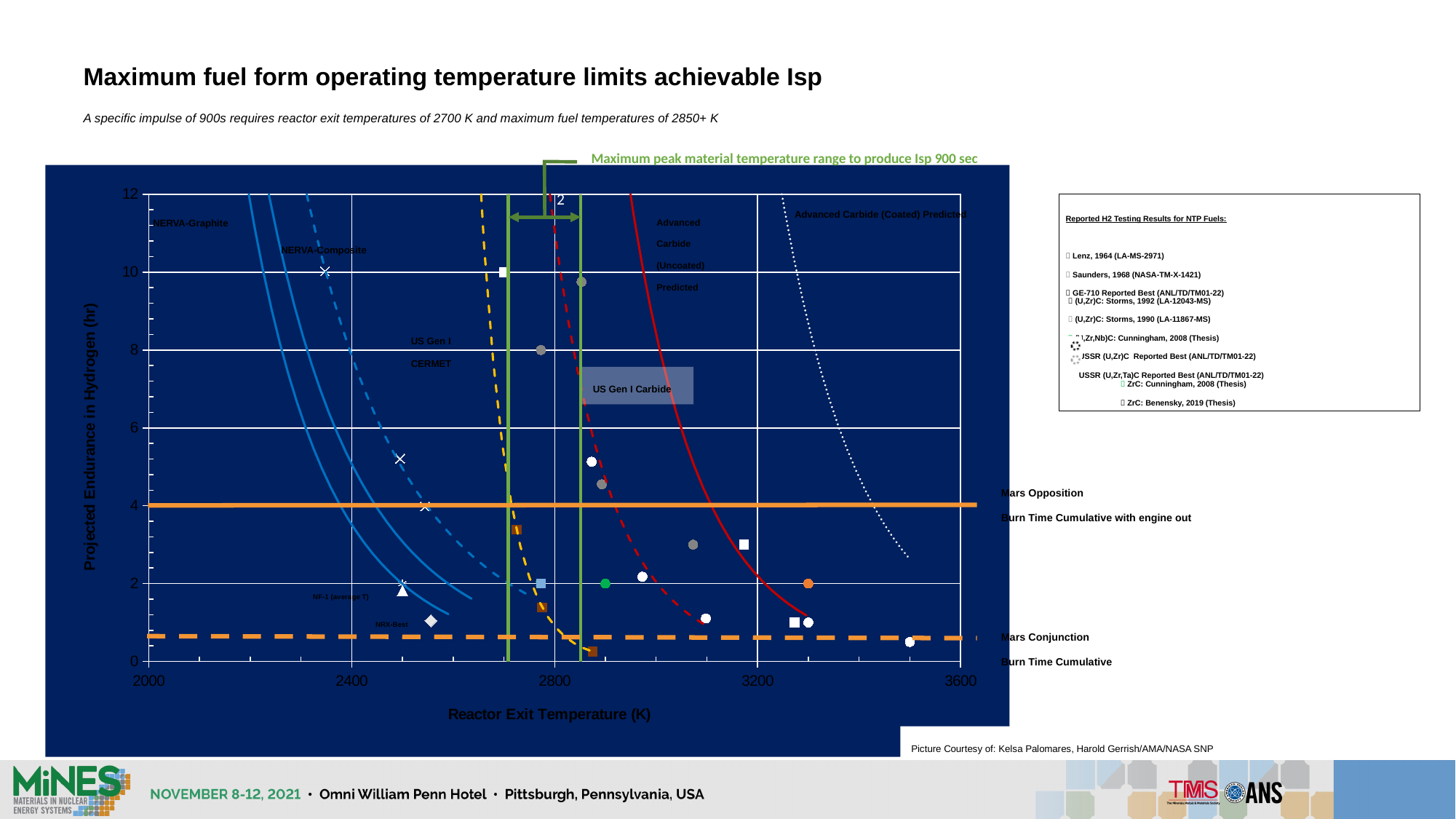
What does the green vertical band on the chart represent? Maximum peak material temperature range to produce Isp 900 sec At what projected endurance value is the solid orange 'Mars Opposition Burn Time Cumulative with engine out' line drawn? 4 Is the reactor exit temperature of the NRX-Best point greater or less than 2400 K? greater Which labelled fuel-form curve lies furthest to the left (lowest reactor exit temperature)? NERVA-Graphite Is the projected endurance of the NF-1 (average T) point greater or less than 4 hr? less As reactor exit temperature increases along the x axis, does the projected endurance of each fuel-form curve rise or fall? fall Which labelled fuel-form curve lies furthest to the right (highest reactor exit temperature)? Advanced Carbide (Coated) Predicted Is the projected endurance of the NRX-Best point greater or less than 2 hr? less What is the title of the x axis of the chart? Reactor Exit Temperature (K) Which is higher on the chart, the Mars Opposition line or the Mars Conjunction line? Mars Opposition What kind of chart is shown on the slide? Scatter chart with curves (line/scatter chart)